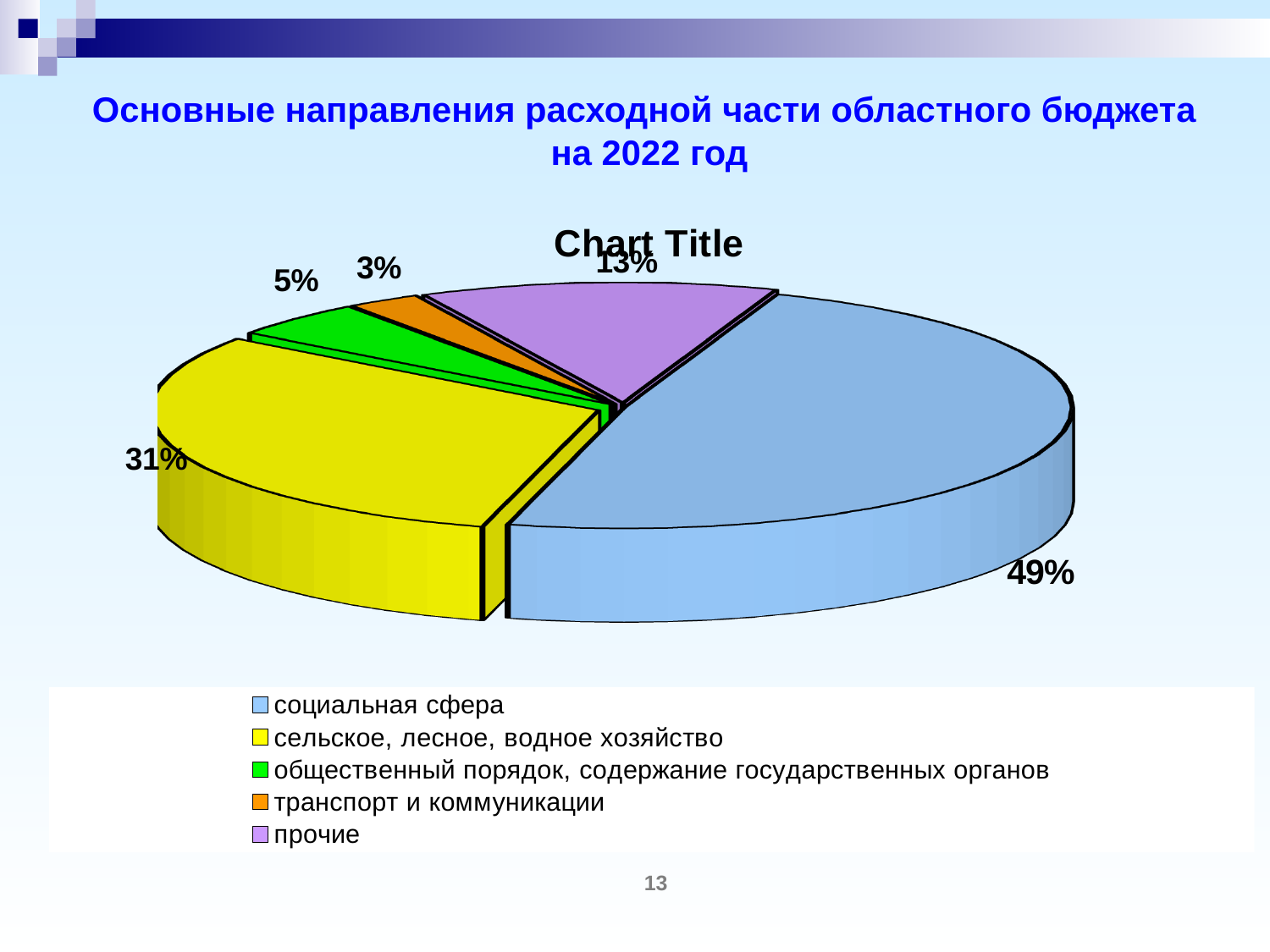
Which is larger, the share for прочие or the share for общественный порядок, содержание государственных органов? прочие What colour is the slice for сельское, лесное, водное хозяйство? yellow What kind of chart is shown on the slide? pie chart What share of the pie does сельское, лесное, водное хозяйство have? 31% What share of the pie does транспорт и коммуникации have? 3% Which category has the smallest slice of the pie? транспорт и коммуникации How many categories does the pie chart show? 5 What share of the pie does прочие have? 13% What is the difference in percentage points between социальная сфера and сельское, лесное, водное хозяйство? 18 Which category has the largest slice of the pie? социальная сфера